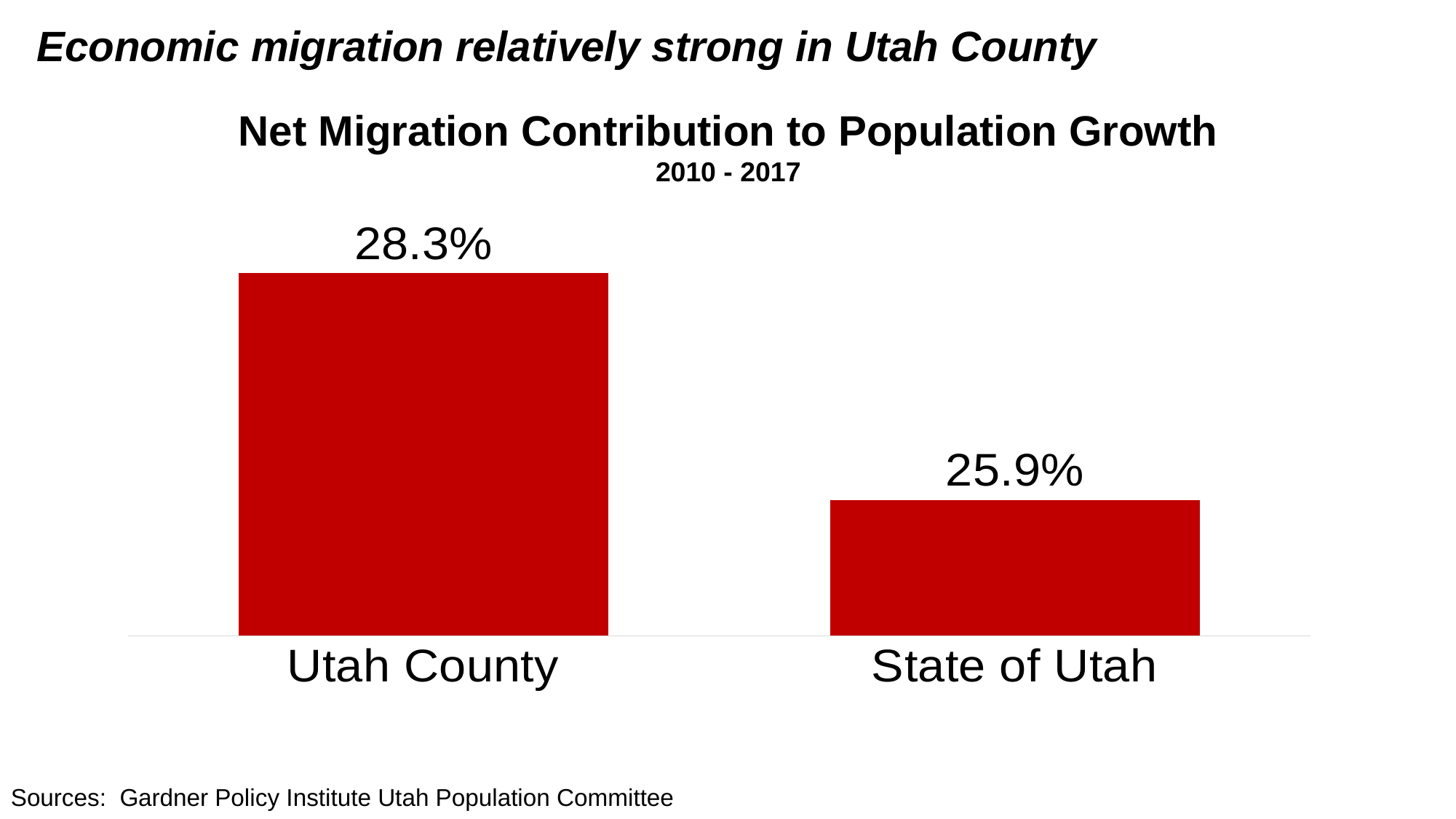
What is the difference in percentage points between Utah County and the State of Utah? 2.4 percentage points Which category has the lower net migration contribution to population growth? State of Utah What time period does the chart cover? 2010 - 2017 Is the value for Utah County larger or smaller than the value for the State of Utah? larger Which category has the higher net migration contribution to population growth? Utah County What is the title of the chart? Net Migration Contribution to Population Growth What is the net migration contribution to population growth for Utah County? 28.3% What kind of chart is shown on the slide? bar chart How many categories are shown in the chart? 2 What is the net migration contribution to population growth for the State of Utah? 25.9%